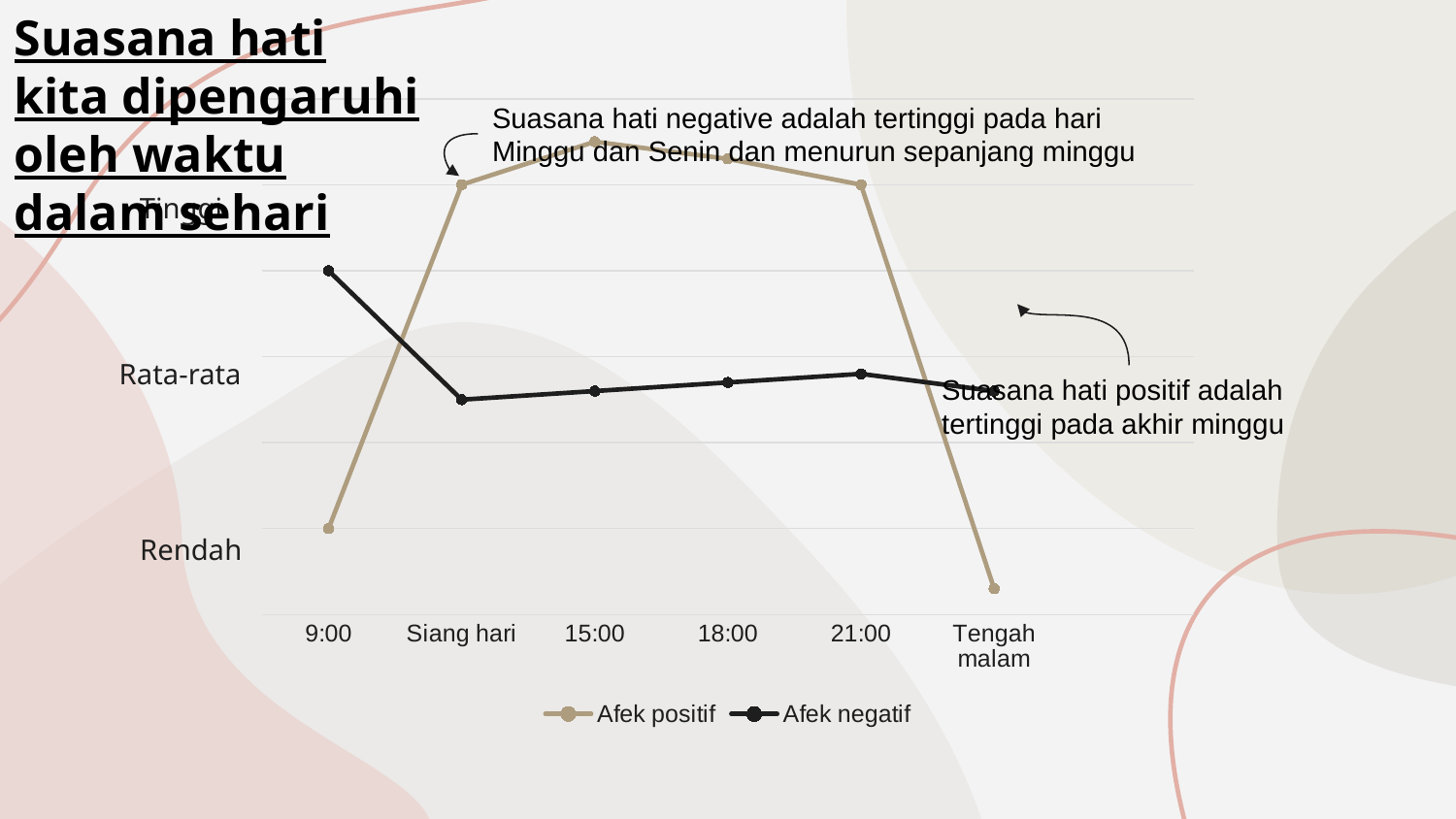
At 15:00, which series has the higher value, Afek positif or Afek negatif? Afek positif How many series does the legend list? 2 What kind of chart is shown on the slide? line chart At Tengah malam, which series has the higher value, Afek positif or Afek negatif? Afek negatif At which time point is Afek negatif highest? 9:00 How many time points are shown on the x axis? 6 Does Afek positif rise or fall from 21:00 to Tengah malam? fall Which two series are listed in the legend? Afek positif and Afek negatif At 9:00, which series has the higher value, Afek positif or Afek negatif? Afek negatif At which time point is Afek positif highest? 15:00 At which time point is Afek positif lowest? Tengah malam Does Afek negatif rise or fall from 9:00 to Siang hari? fall